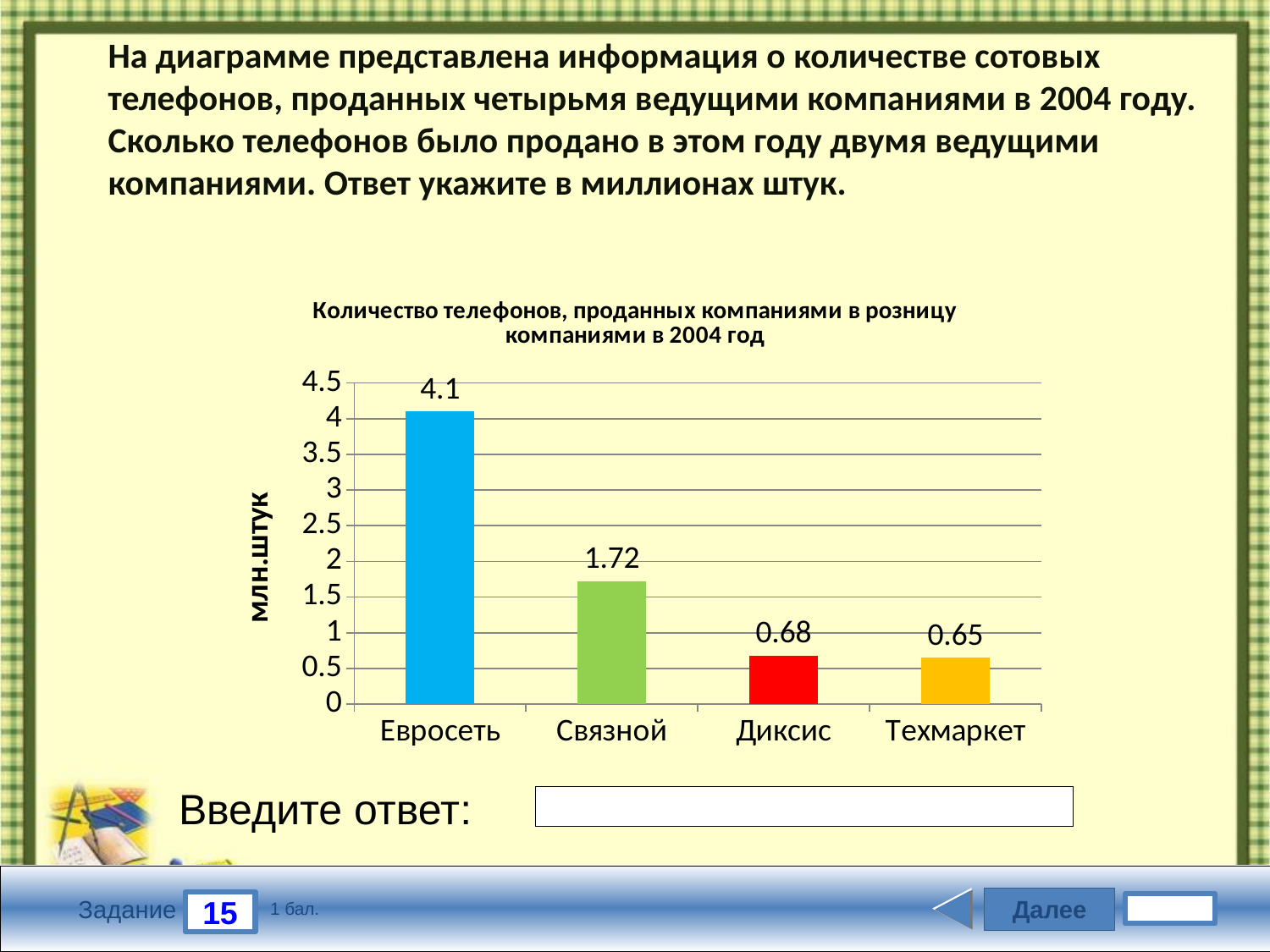
What is the value for Техмаркет? 0.65 What is the difference between the values for Евросеть and Связной? 2.38 What is the value for Диксис? 0.68 What is the value for Связной? 1.72 Which is larger, the value for Диксис or the value for Техмаркет? Диксис What is the value for Евросеть? 4.1 How many companies are shown on the chart? 4 What kind of chart is shown on the slide? bar chart Is the value for Связной greater or less than 2? less What is the label of the vertical axis? млн.штук Which company has the lowest value? Техмаркет Which company has the highest value? Евросеть